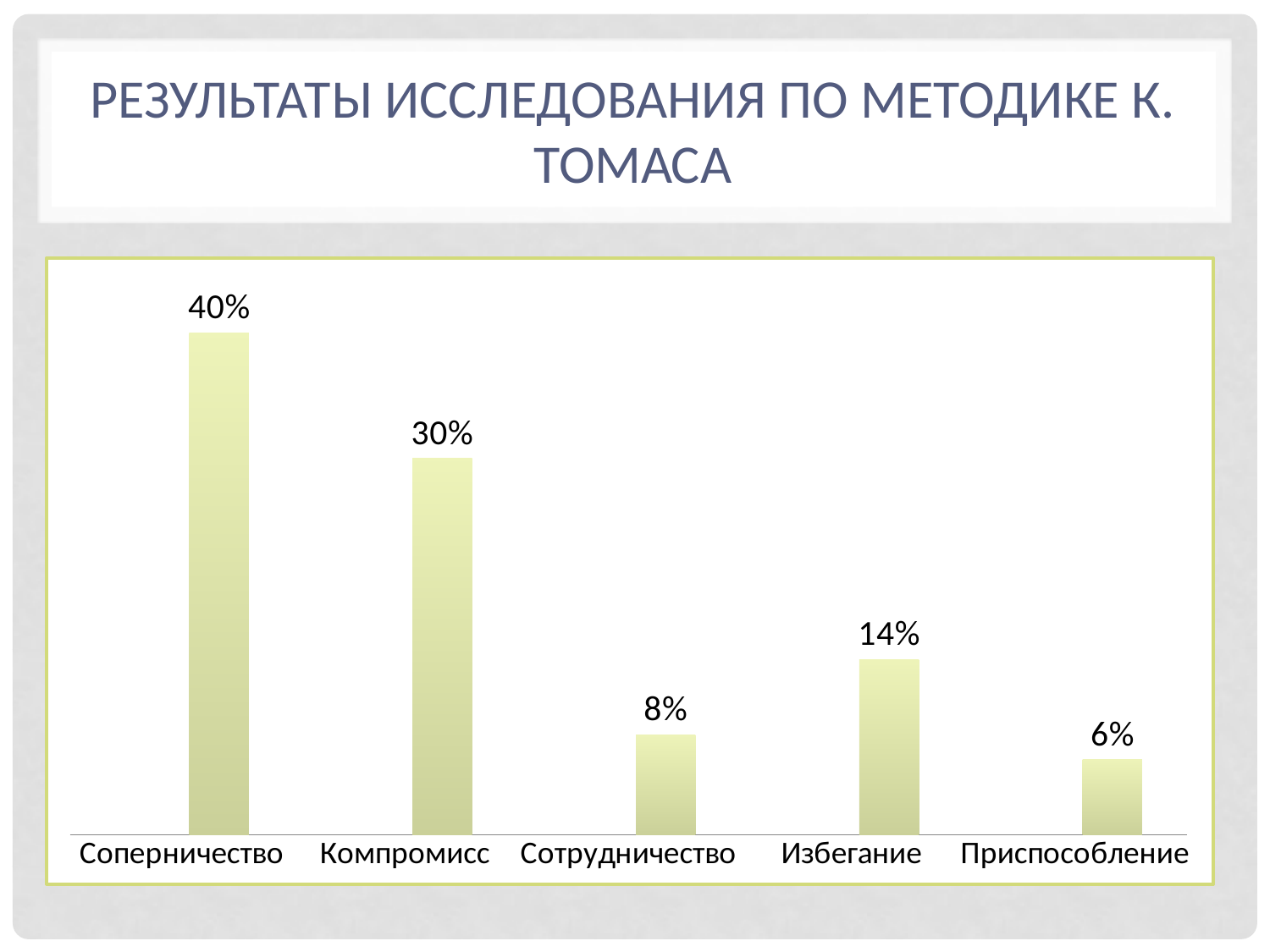
What is the difference between the values for Избегание and Сотрудничество? 6% How many categories are shown in the chart? 5 What kind of chart is shown on the slide? Bar chart Which category has the lowest value? Приспособление Which is larger, the value for Избегание or the value for Сотрудничество? Избегание What is the value for Избегание? 14% What is the value for Сотрудничество? 8% Which category has the highest value? Соперничество What is the value for Компромисс? 30% What is the difference between the values for Соперничество and Компромисс? 10% What is the value for Приспособление? 6% What is the value for Соперничество? 40%